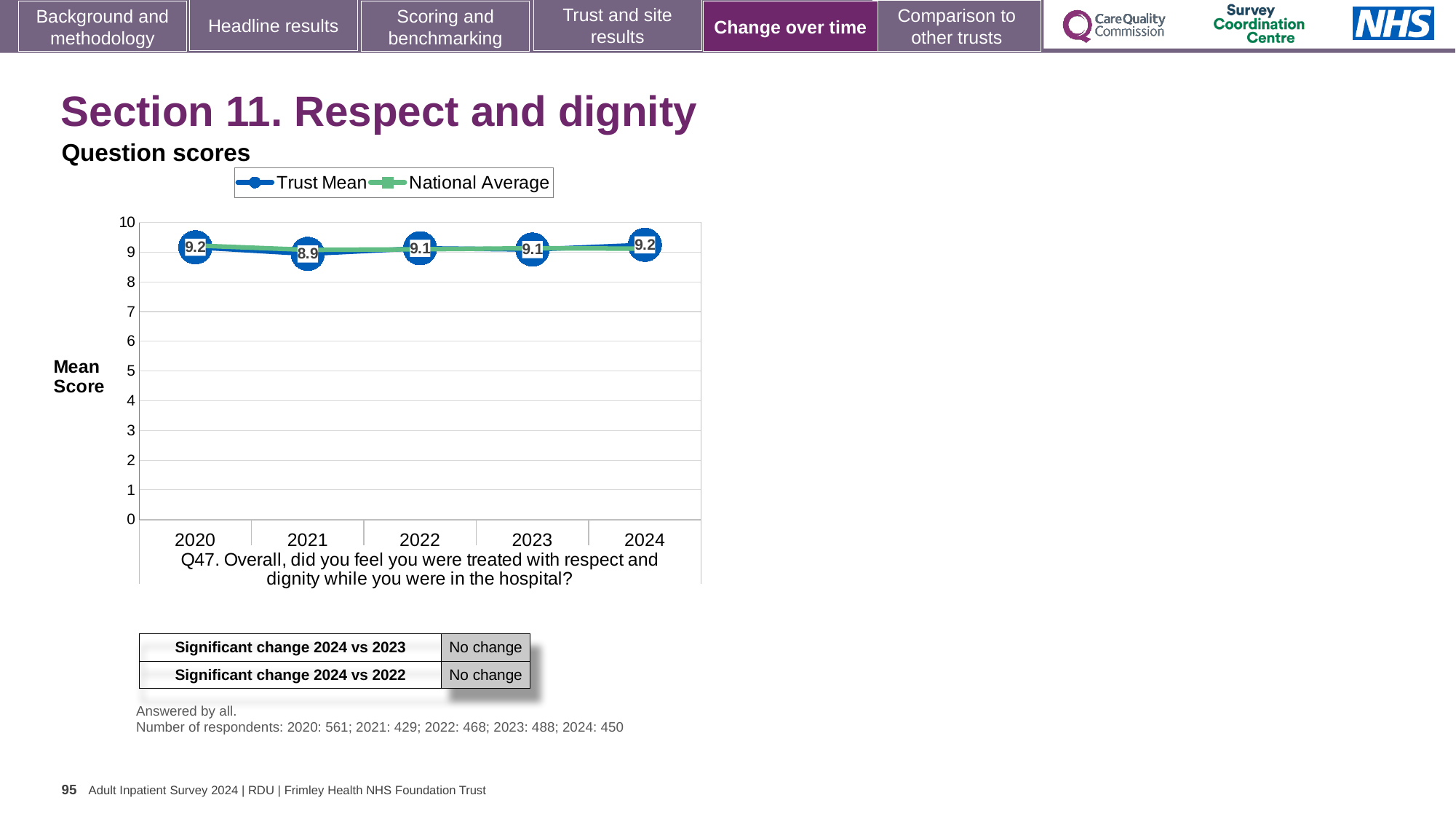
What is the difference between the Trust Mean score in 2024 and in 2021? 0.3 How many years are plotted on the x axis? 5 How many series does the legend list? 2 What is the Trust Mean score for 2021? 8.9 What kind of chart is shown? Line chart What is the Trust Mean score for 2022? 9.1 Which is larger, the Trust Mean score for 2021 or for 2022? 2022 Does the Trust Mean score rise or fall from 2021 to 2024? Rise What are the two series named in the legend? Trust Mean and National Average Which year has the lowest Trust Mean score? 2021 What is the Trust Mean score for 2024? 9.2 Is the National Average value for 2023 greater or less than 8? greater